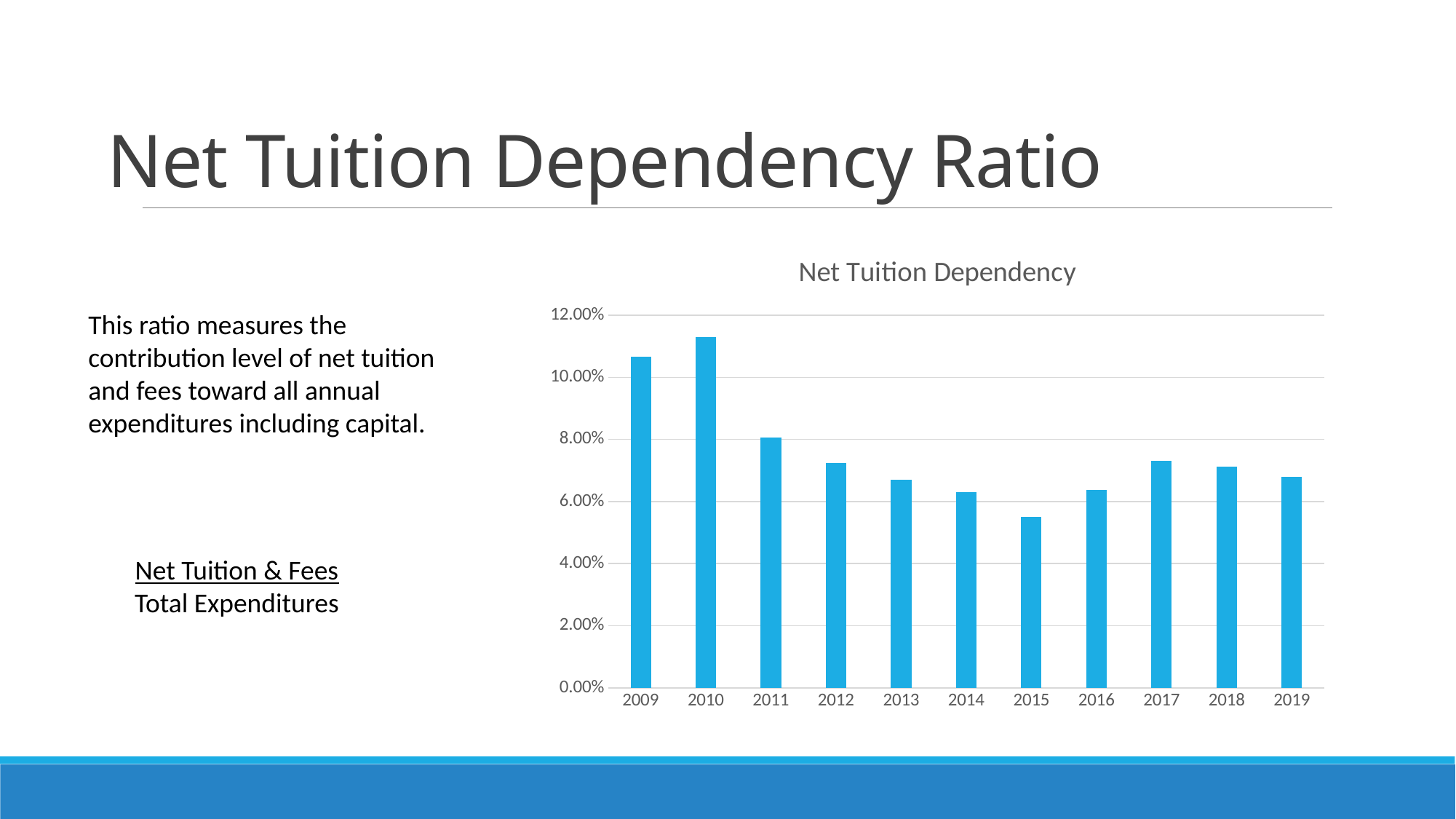
How many years are plotted on the chart? 11 Is the value for 2009 greater or less than 10.00%? greater Which is larger, the value for 2017 or the value for 2015? 2017 Is the value for 2010 greater or less than 10.00%? greater Which year has the highest net tuition dependency? 2010 Which year has the lowest net tuition dependency? 2015 Is the value for 2015 greater or less than 6.00%? less What kind of chart is shown on the slide? bar chart Do the values rise or fall from 2010 to 2015? fall What is the title of the chart? Net Tuition Dependency Which is larger, the value for 2009 or the value for 2011? 2009